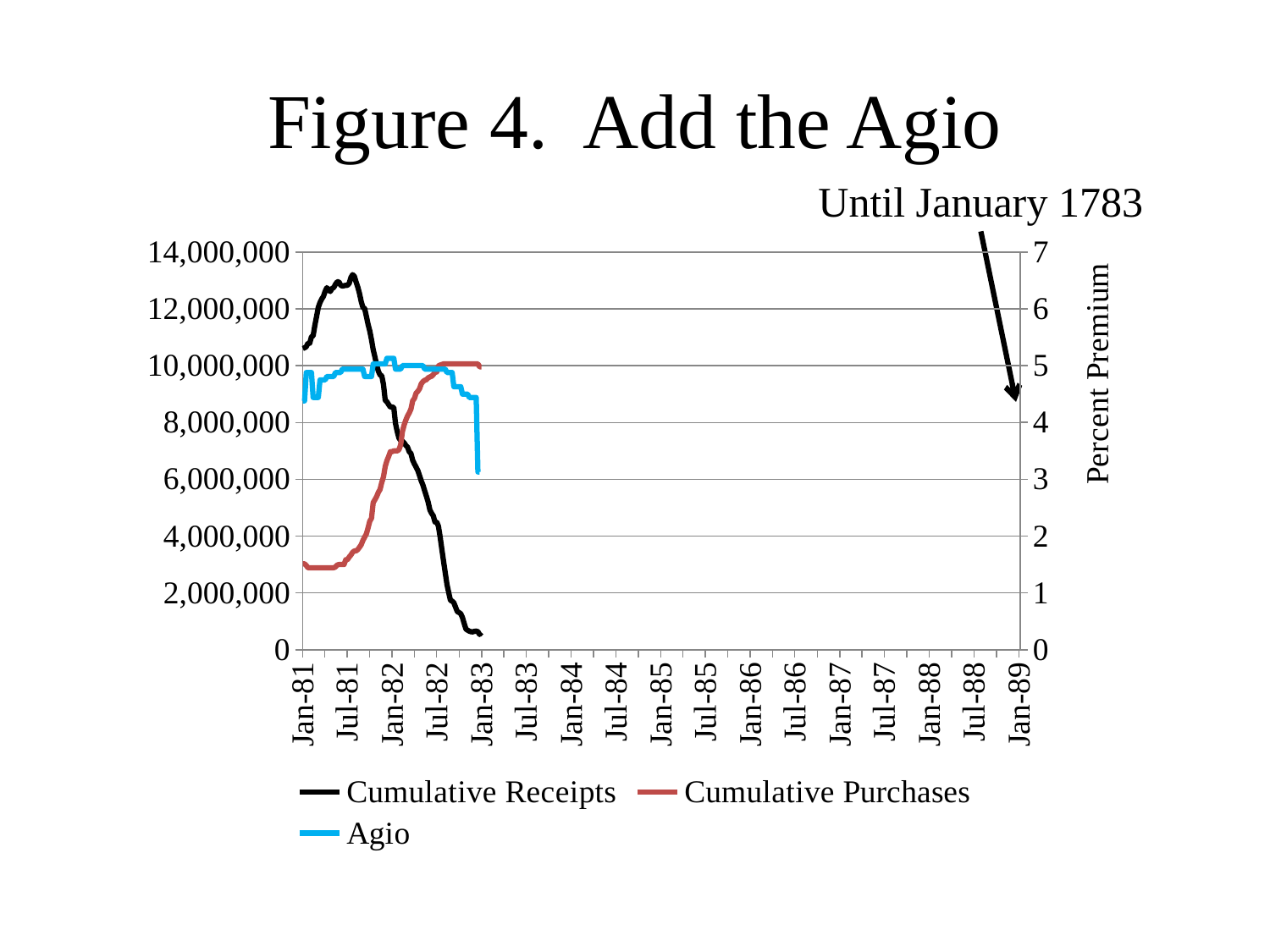
What is the title of the right-hand vertical axis? Percent Premium At Jul-82, which is larger, Cumulative Receipts or Cumulative Purchases? Cumulative Purchases Which series reaches the highest value on the left-hand axis? Cumulative Receipts Is the value of Cumulative Purchases at Jan-81 greater or less than 4,000,000? less What kind of chart is shown on the slide? line chart Is the peak value of Cumulative Receipts greater or less than 12,000,000? greater Does the Cumulative Purchases series rise or fall between Jan-81 and Jan-83? rise Is the value of Cumulative Receipts at Jan-83 greater or less than 2,000,000? less Which series are listed in the legend? Cumulative Receipts, Cumulative Purchases, Agio How many series does the legend list? 3 Does the Cumulative Receipts series rise or fall between Jul-81 and Jan-83? fall